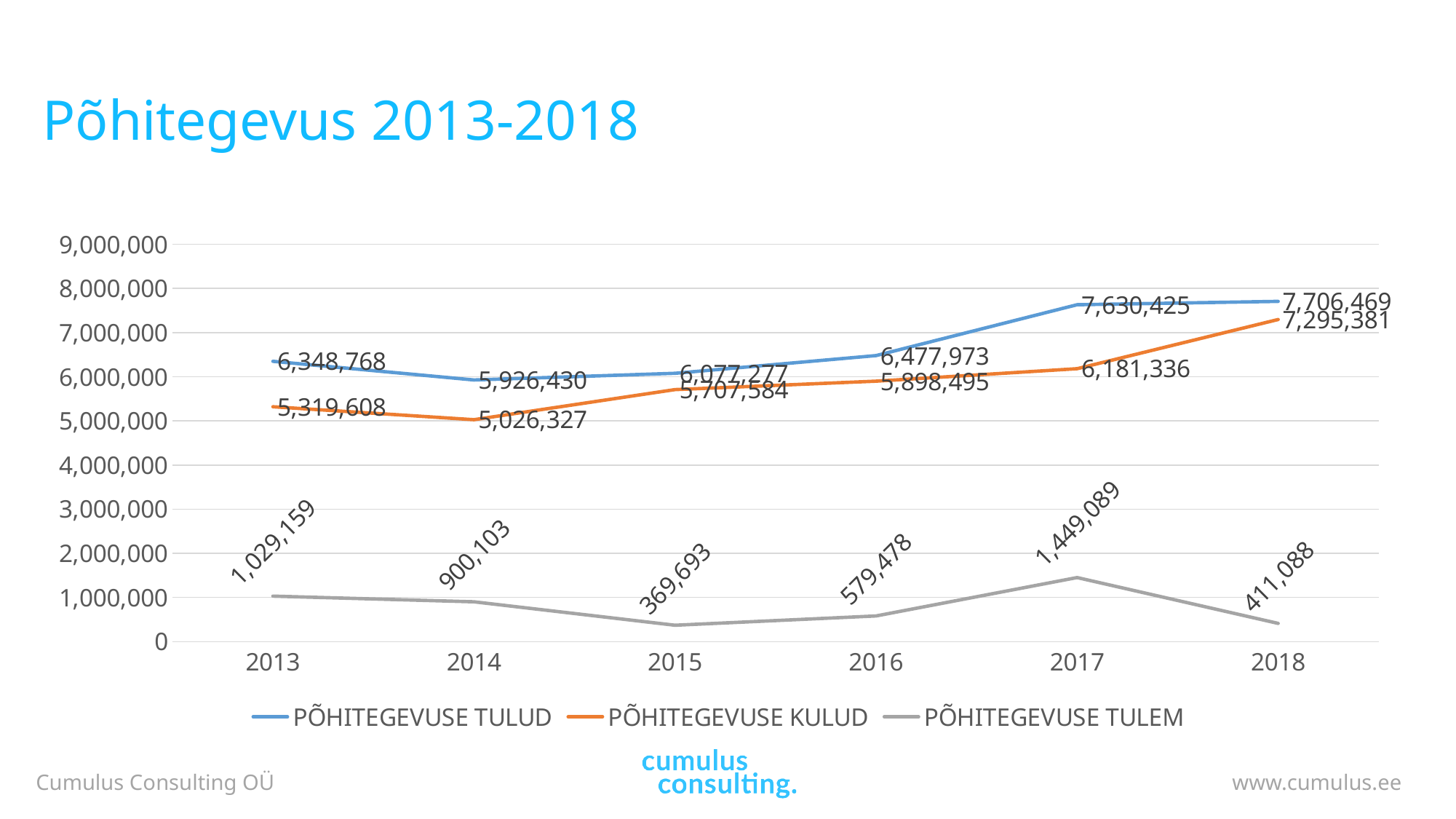
Which is larger in 2013: PÕHITEGEVUSE TULUD or PÕHITEGEVUSE KULUD? PÕHITEGEVUSE TULUD In which year is PÕHITEGEVUSE KULUD lowest? 2014 What is the value of PÕHITEGEVUSE TULUD in 2017? 7,630,425 What is the value of PÕHITEGEVUSE KULUD in 2014? 5,026,327 What kind of chart is shown on the slide? line chart How many series does the legend list? 3 In which year is PÕHITEGEVUSE TULEM lowest? 2015 In which year is PÕHITEGEVUSE TULEM highest? 2017 How many years are shown on the x axis? 6 What is the difference between PÕHITEGEVUSE TULUD and PÕHITEGEVUSE KULUD in 2018? 411,088 Is the value of PÕHITEGEVUSE KULUD in 2018 greater or less than 7,000,000? greater What is the value of PÕHITEGEVUSE TULEM in 2016? 579,478